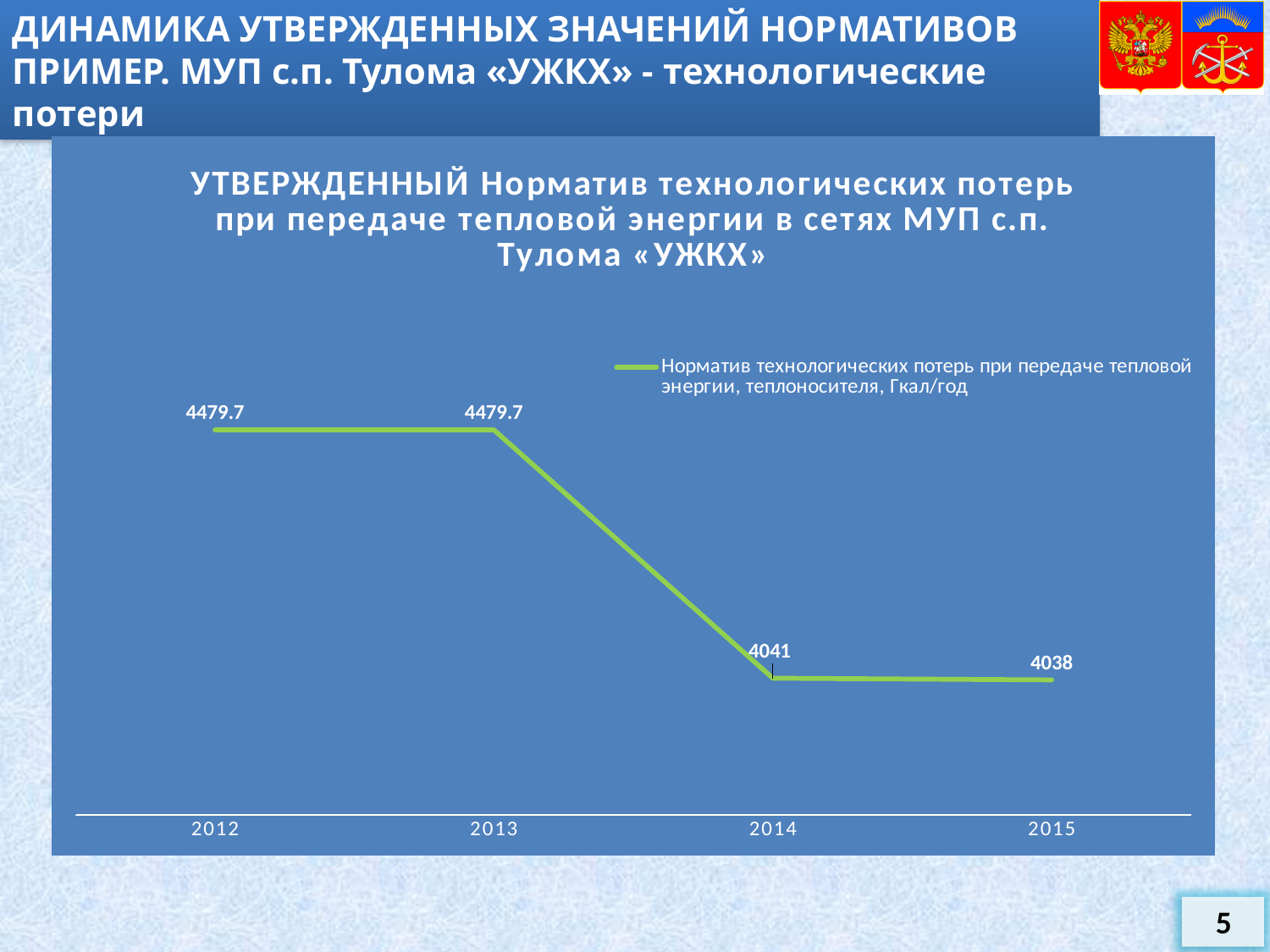
What is the value for 2012? 4479.7 Do the values rise or fall from 2012 to 2015? fall How many years are plotted on the x axis? 4 What is the difference between the values for 2014 and 2015? 3 What is the value for 2014? 4041 What is the difference between the values for 2013 and 2014? 438.7 What unit is given in the legend entry? Гкал/год Which is larger, the value for 2012 or the value for 2014? 2012 What kind of chart is shown? line chart Which year has the lowest value? 2015 What is the value for 2015? 4038 How many series does the legend list? 1